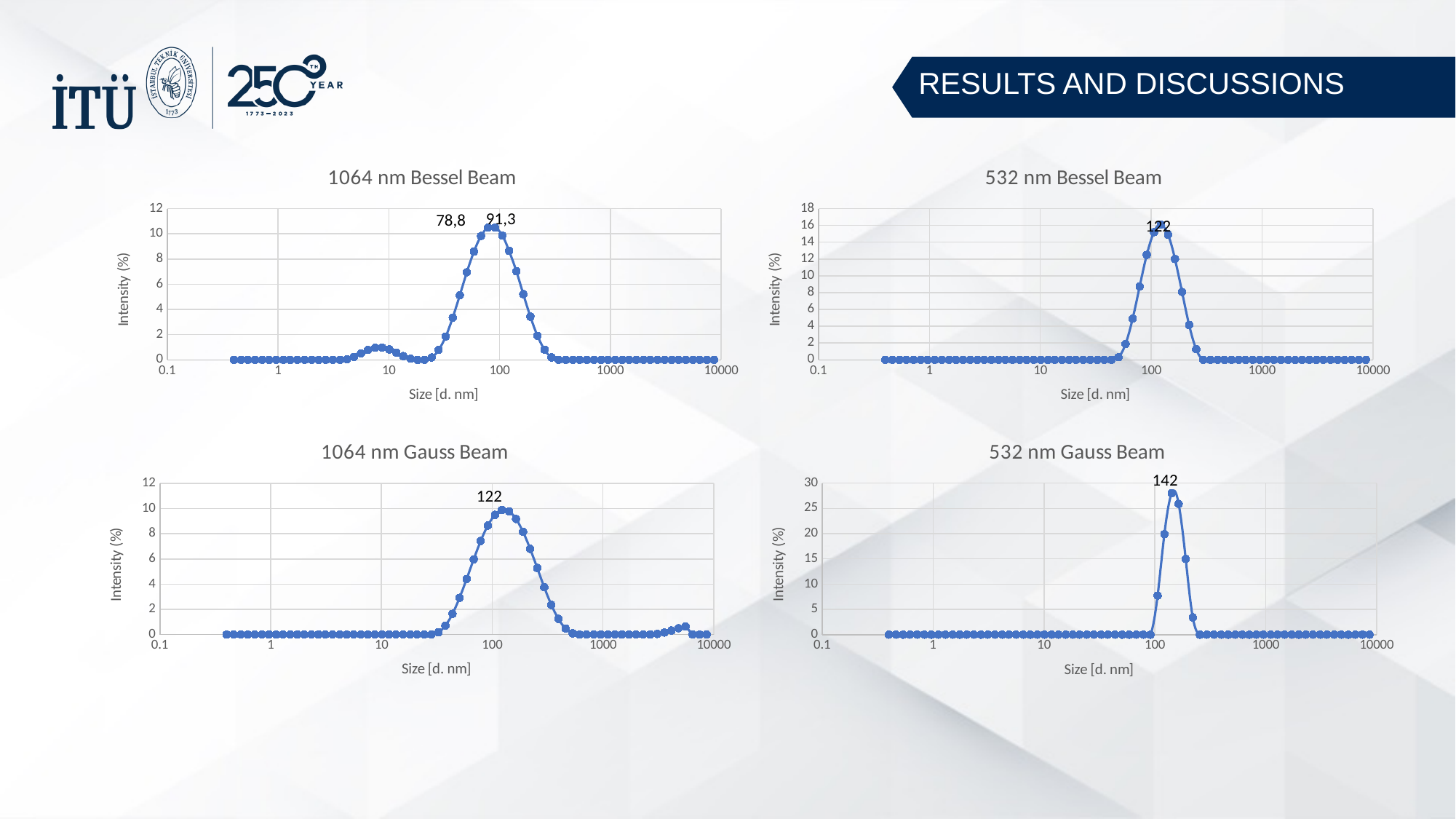
In the 532 nm Gauss Beam chart, is the peak intensity greater or less than 25? greater Which of the four charts has the highest peak intensity? 532 nm Gauss Beam What kind of chart is the 1064 nm Bessel Beam chart? Line chart with markers In the 532 nm Bessel Beam chart, do the values rise or fall from the peak toward 1000 on the x axis? fall In the 1064 nm Bessel Beam chart, which two data labels appear near the peak of the curve? 78,8 and 91,3 In the 532 nm Gauss Beam chart, what data label marks the peak of the curve? 142 What is the y-axis title on the 1064 nm Gauss Beam chart? Intensity (%) In the 1064 nm Bessel Beam chart, is the peak intensity greater or less than 8? greater How many charts are shown on the slide? 4 In the 1064 nm Gauss Beam chart, what data label marks the peak of the curve? 122 In the 532 nm Bessel Beam chart, what data label marks the peak of the curve? 122 In the 532 nm Bessel Beam chart, is the peak intensity greater or less than 14? greater